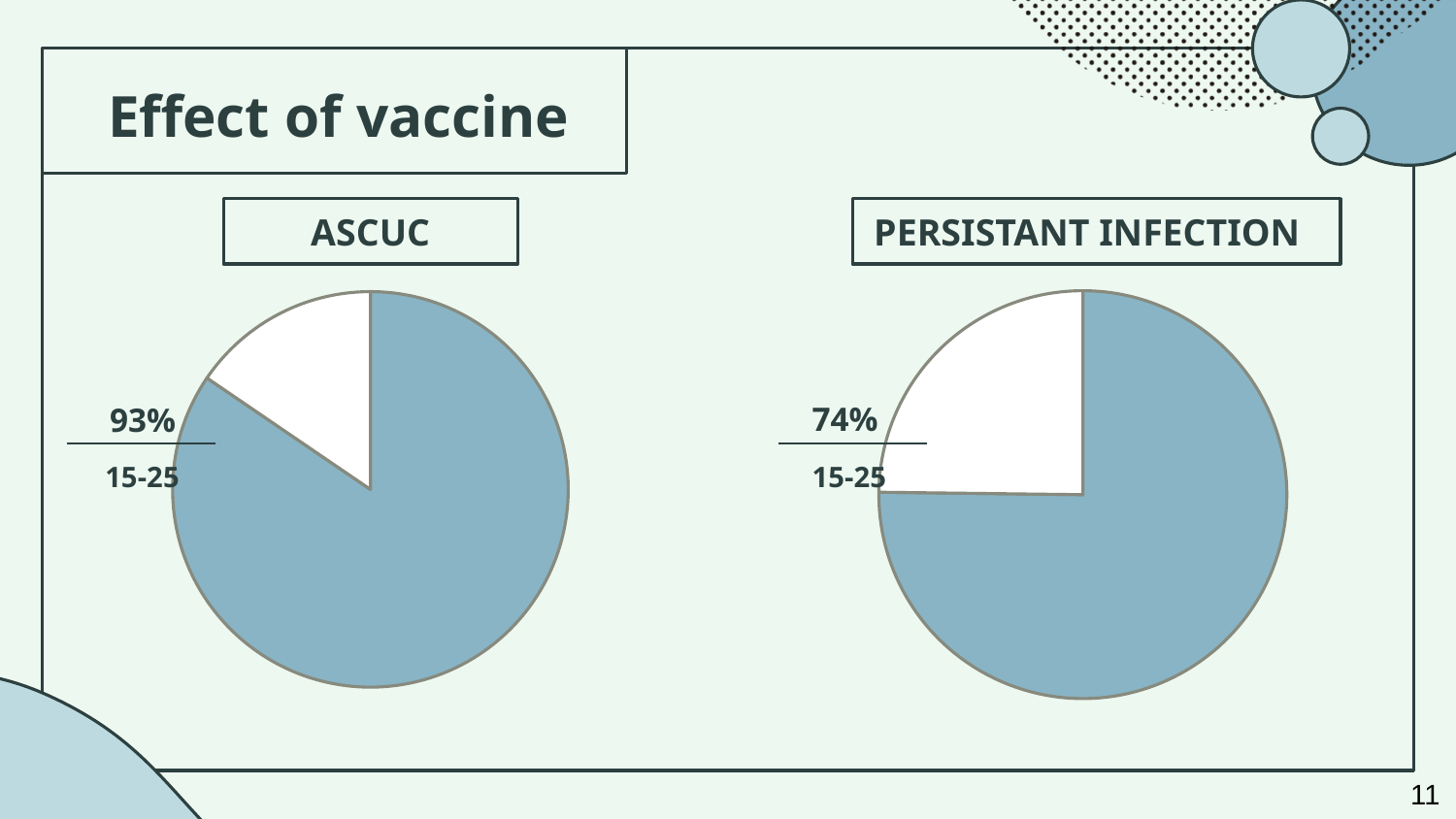
In the ASCUC pie chart, what percentage is shown for the 15-25 group? 93% How many slices does the PERSISTANT INFECTION pie chart have? 2 What is the difference between the percentage shown in the ASCUC chart and the percentage shown in the PERSISTANT INFECTION chart? 19 percentage points What is the title of the slide containing the two pie charts? Effect of vaccine In the PERSISTANT INFECTION pie chart, is the blue slice larger or smaller than the white slice? larger Which chart shows the larger percentage for the 15-25 group, ASCUC or PERSISTANT INFECTION? ASCUC What kind of chart is used under the ASCUC heading? pie chart What age group label appears next to both pie charts? 15-25 In the PERSISTANT INFECTION pie chart, what percentage is shown for the 15-25 group? 74% How many slices does the ASCUC pie chart have? 2